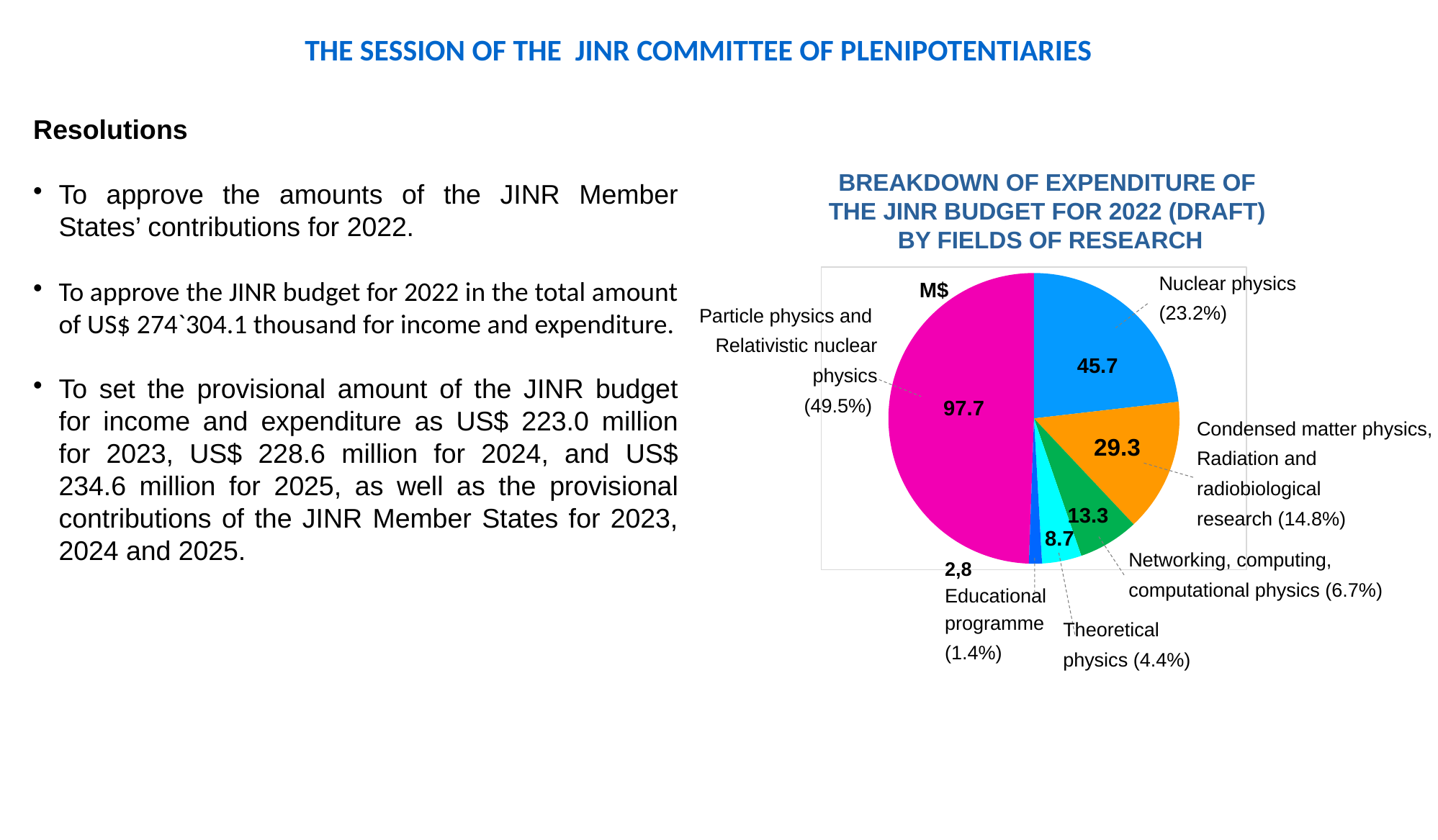
How many slices does the pie chart have? 6 What share of the pie does Condensed matter physics, Radiation and radiobiological research take? 14.8% What is the value for Networking, computing, computational physics? 13.3 What unit is indicated on the pie chart? M$ Which is larger, the value for Networking, computing, computational physics or the value for Theoretical physics? Networking, computing, computational physics What is the value for Particle physics and Relativistic nuclear physics? 97.7 Which field of research has the largest slice of the pie? Particle physics and Relativistic nuclear physics What kind of chart is shown on the slide? pie chart What is the value for Nuclear physics in the pie chart? 45.7 What is the difference between the values for Nuclear physics and Condensed matter physics, Radiation and radiobiological research? 16.4 What share of the pie does Theoretical physics take? 4.4% Which field of research has the smallest slice of the pie? Educational programme